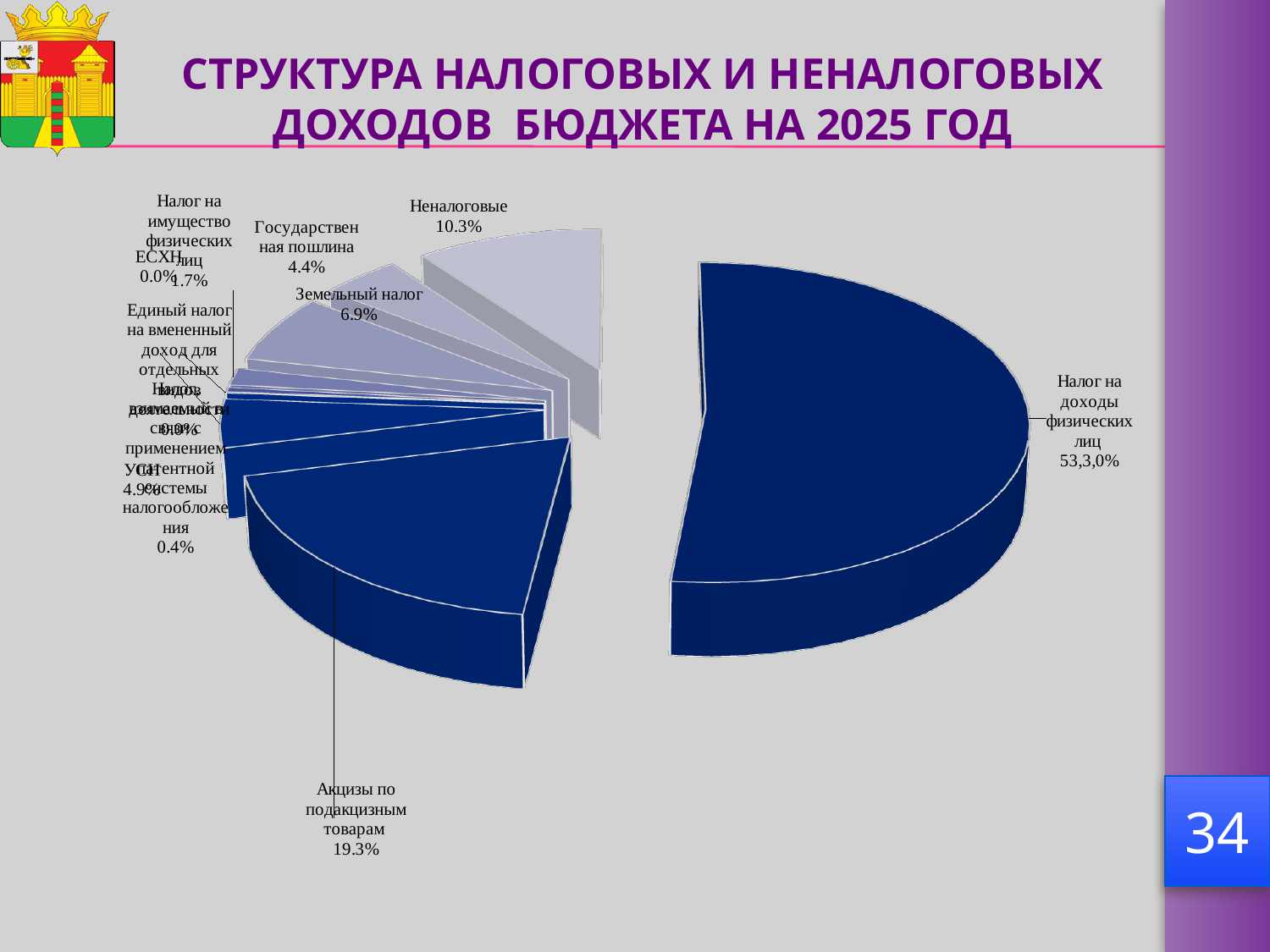
What share of the pie is labelled for Неналоговые? 10.3% What share of the pie is labelled for Земельный налог? 6.9% What share of the pie is labelled for ЕСХН? 0.0% What is the difference between the shares for Земельный налог and Государственная пошлина? 2.5% Which category has the largest slice of the pie? Налог на доходы физических лиц Which is larger: the slice for Неналоговые or the slice for Земельный налог? Неналоговые What is the difference between the shares for Акцизы по подакцизным товарам and Неналоговые? 9.0% What is the title of the slide containing the chart? СТРУКТУРА НАЛОГОВЫХ И НЕНАЛОГОВЫХ ДОХОДОВ БЮДЖЕТА НА 2025 ГОД What kind of chart is shown on the slide? pie chart